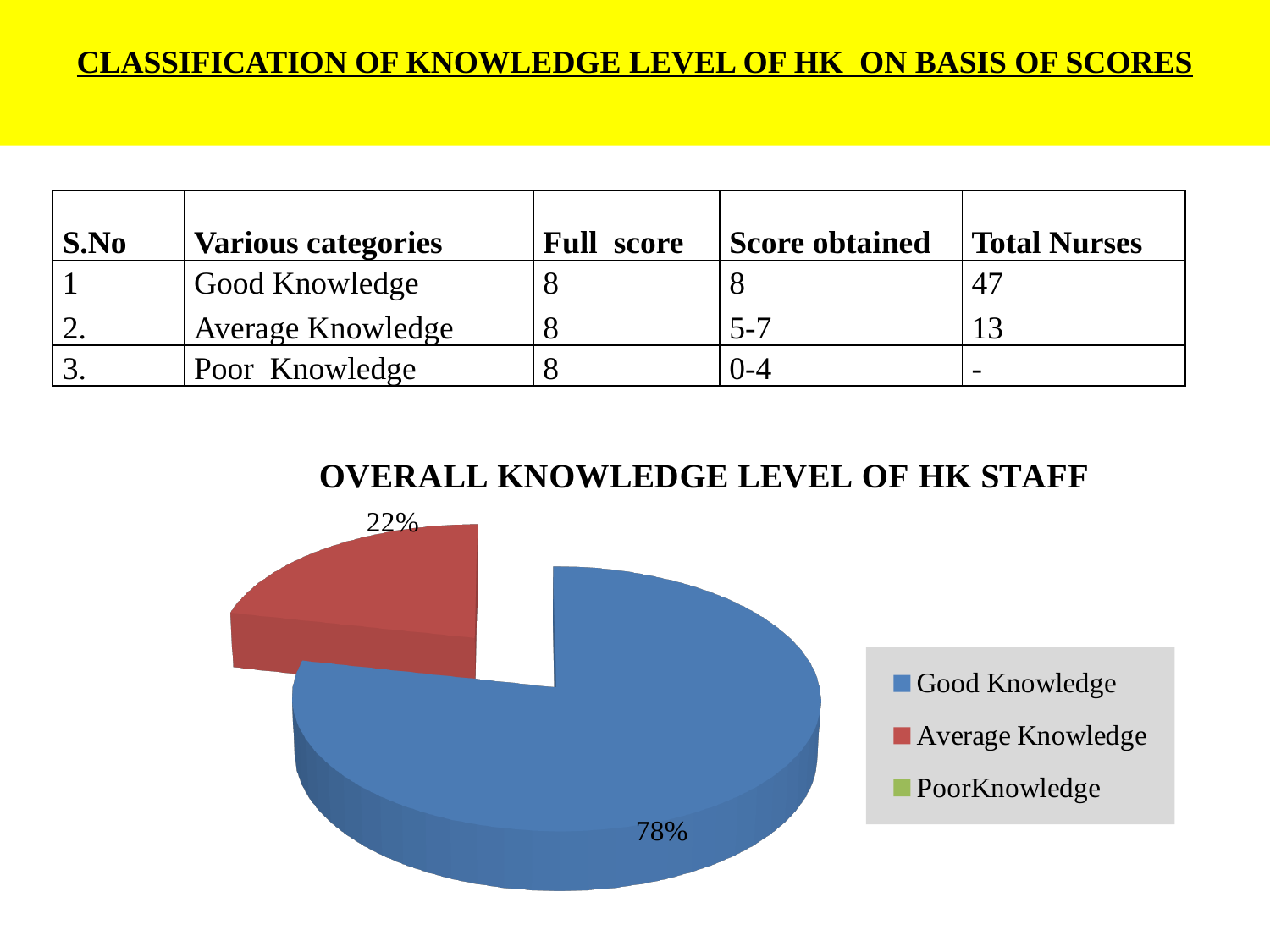
What percentage of the pie is labelled for Average Knowledge? 22% What kind of chart is shown on the slide? Pie chart Is the share for Average Knowledge greater or less than 50%? less What is the title of the chart? OVERALL KNOWLEDGE LEVEL OF HK STAFF What colour is the Good Knowledge slice? Blue Which category has the largest slice of the pie? Good Knowledge What is the difference in percentage points between the Good Knowledge slice and the Average Knowledge slice? 56 How many entries does the legend list? 3 How many slices are visible in the pie? 2 What percentage of the pie is labelled for Good Knowledge? 78% Which of the two labelled slices is larger, Good Knowledge or Average Knowledge? Good Knowledge